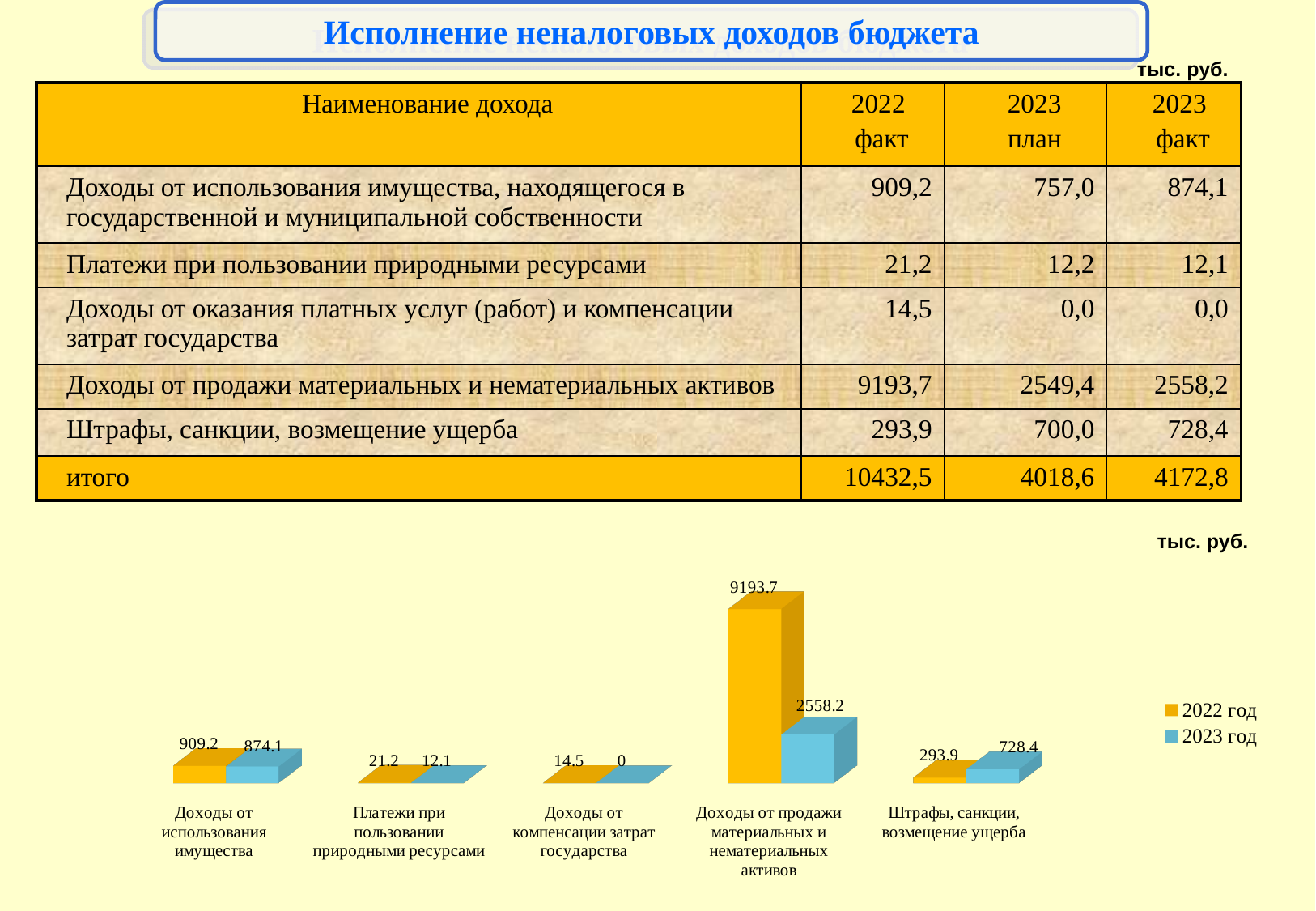
For Штрафы, санкции, возмещение ущерба, which is larger in the chart: the 2022 год value or the 2023 год value? 2023 год Which colour represents the 2022 год series in the chart? yellow What is the 2023 год value for Штрафы, санкции, возмещение ущерба in the chart? 728.4 Which category has the highest 2022 год value in the chart? Доходы от продажи материальных и нематериальных активов What is the 2022 год value for Доходы от продажи материальных и нематериальных активов in the chart? 9193.7 What type of chart is shown on the slide? bar chart What is the difference between the 2022 год and 2023 год values for Доходы от продажи материальных и нематериальных активов in the chart? 6635.5 How many series does the chart legend list? 2 How many categories are shown on the chart's x axis? 5 What is the 2022 год value for Платежи при пользовании природными ресурсами in the chart? 21.2 Which category has the lowest 2023 год value in the chart? Доходы от компенсации затрат государства What is the 2023 год value for Доходы от использования имущества in the chart? 874.1